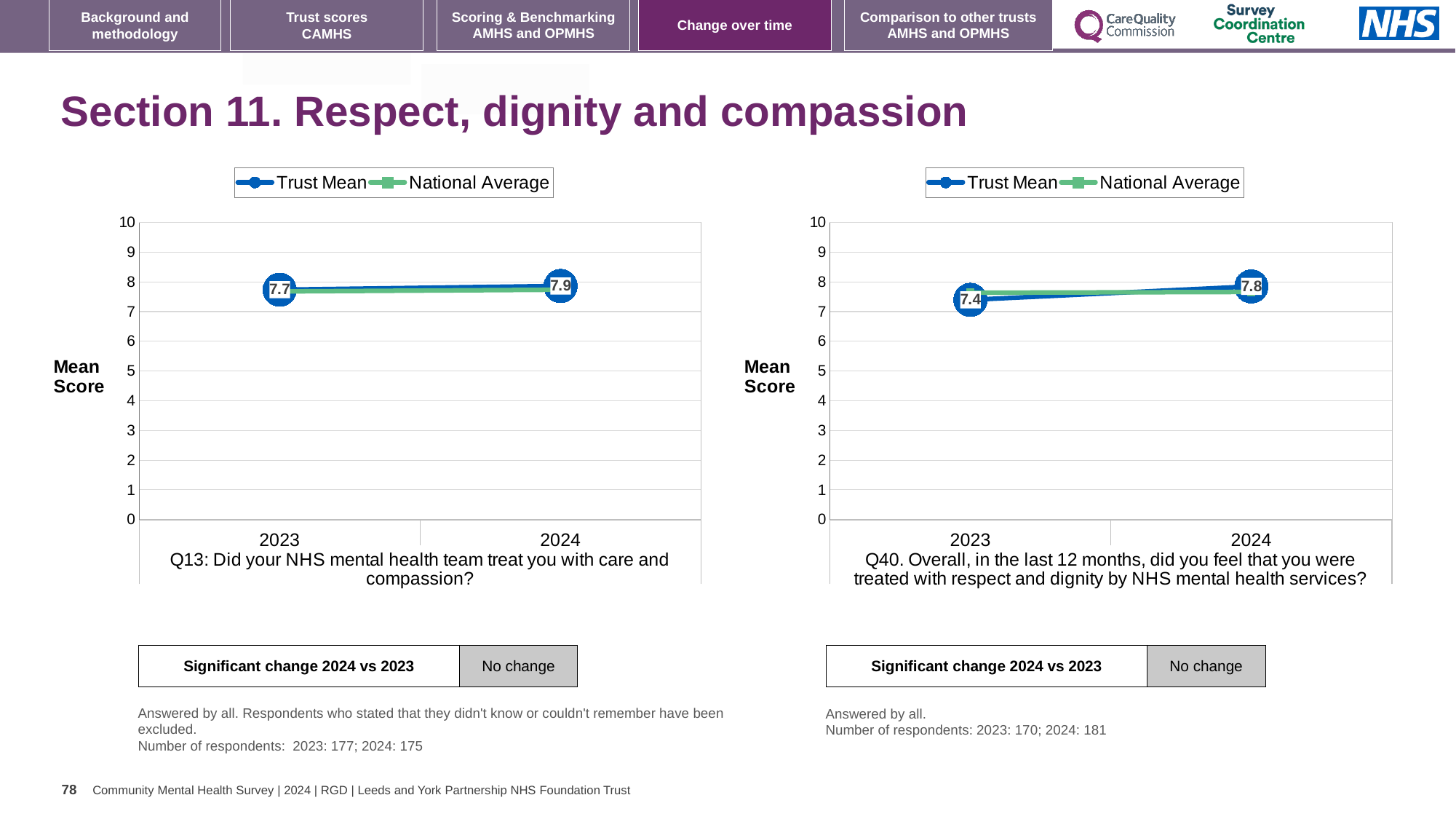
In the Q40 chart (right), does the Trust Mean rise or fall from 2023 to 2024? rise In the Q40 chart (right), what is the Trust Mean score for 2023? 7.4 In the Q13 chart (left), what is the Trust Mean score for 2023? 7.7 In the Q13 chart (left), which year has the higher Trust Mean score? 2024 In the Q40 chart (right), is the Trust Mean for 2023 greater or less than 8? less In the Q40 chart (right), by how much did the Trust Mean change from 2023 to 2024? 0.4 In the Q13 chart (left), what is the Trust Mean score for 2024? 7.9 What type of chart is the Q13 chart (left)? line chart How many series does the legend of the Q13 chart (left) list? 2 In the Q40 chart (right), what is the Trust Mean score for 2024? 7.8 In the Q13 chart (left), by how much did the Trust Mean change from 2023 to 2024? 0.2 How many years are plotted on the x axis of the Q40 chart (right)? 2